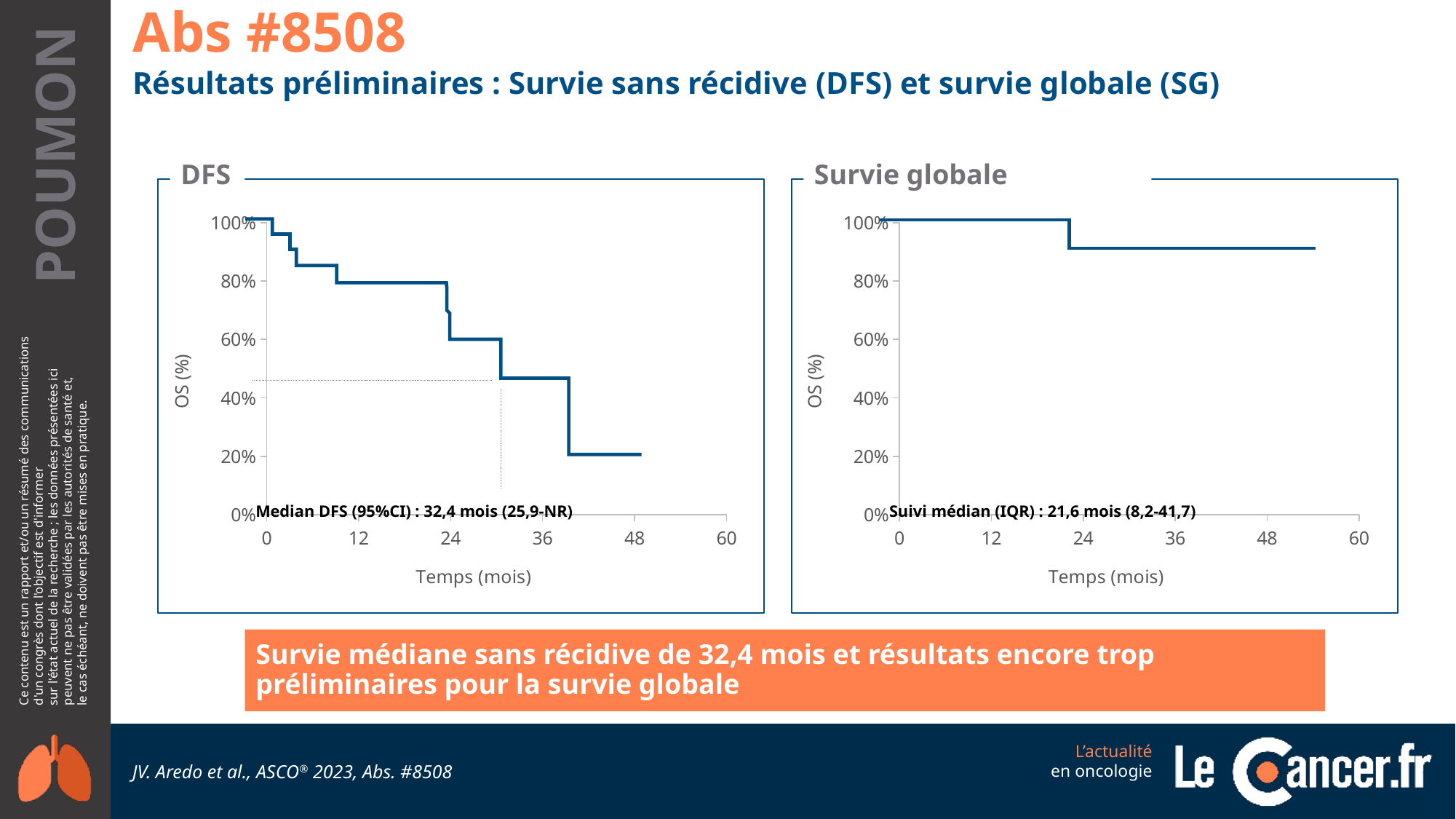
In the DFS chart, does the curve rise or fall as time increases? Fall In the Survie globale chart, what is the IQR of the median follow-up given in the annotation? 8,2-41,7 How many charts are shown on the slide? 2 In the DFS chart, is the value at 48 months greater or less than 40%? less In the DFS chart, what is the 95% CI for the median DFS given in the annotation? 25,9-NR What is the highest tick value shown on the x axis of the DFS chart? 60 In the DFS chart, is the value at 12 months greater or less than 60%? greater In the Survie globale chart, is the value at 48 months greater or less than 80%? greater In the DFS chart, what is the median DFS reported in the annotation? 32,4 mois What is the x-axis label of the Survie globale chart? Temps (mois) What kind of chart is the DFS chart? Line chart (Kaplan-Meier step curve) In the Survie globale chart, what is the median follow-up (suivi médian) reported in the annotation? 21,6 mois